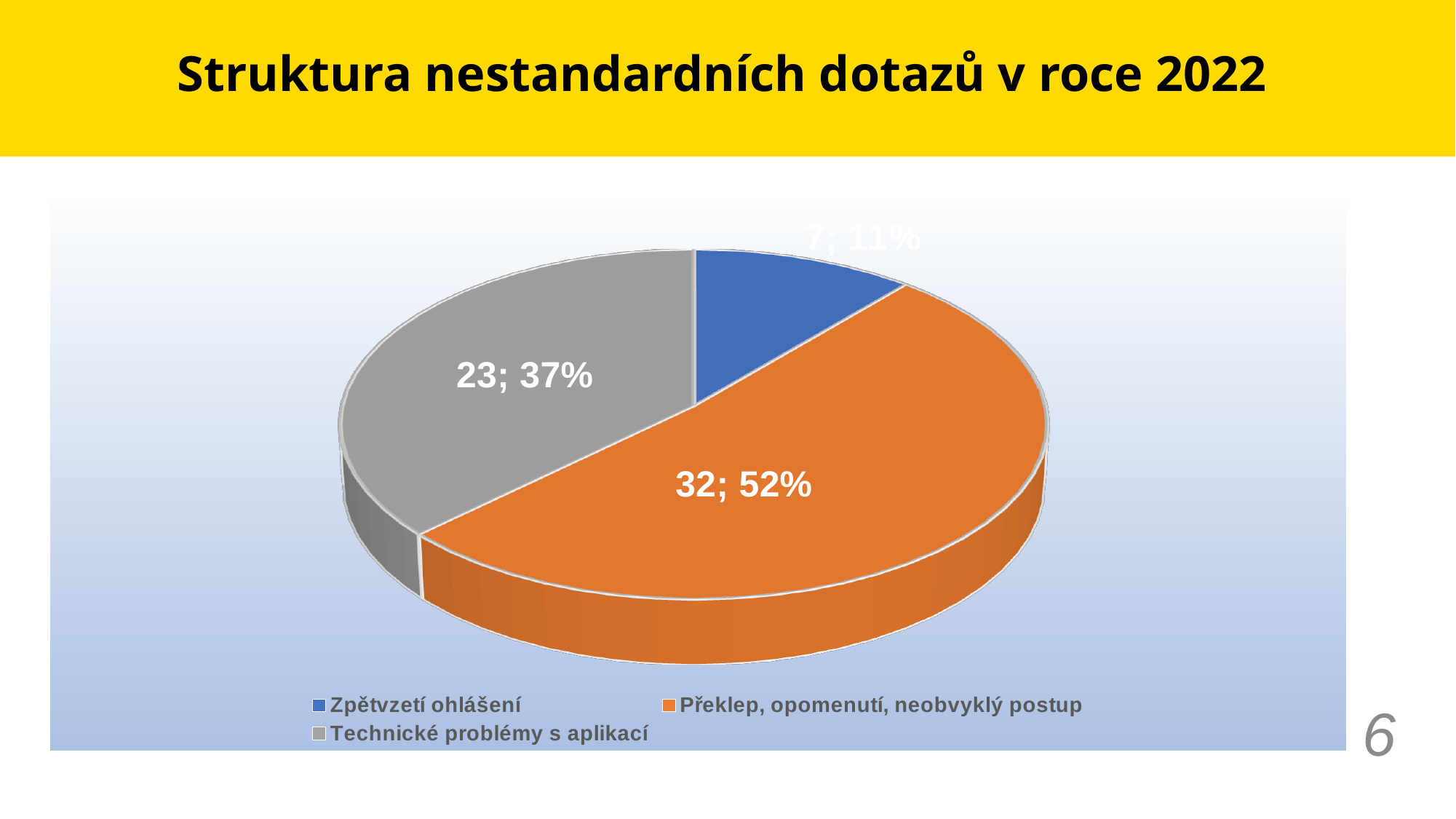
What is the title of the chart on the slide? Struktura nestandardních dotazů v roce 2022 Which category has the smallest slice? Zpětvzetí ohlášení How many slices does the pie chart have? 3 What kind of chart is shown on the slide? pie chart What is the difference between the values for Překlep, opomenutí, neobvyklý postup and Technické problémy s aplikací? 9 Which is larger, the value for Technické problémy s aplikací or the value for Zpětvzetí ohlášení? Technické problémy s aplikací What is the value for Zpětvzetí ohlášení? 7 What share of the pie does Překlep, opomenutí, neobvyklý postup represent? 52% What share of the pie does Technické problémy s aplikací represent? 37% What is the value for Technické problémy s aplikací? 23 Which category has the largest slice? Překlep, opomenutí, neobvyklý postup What is the value for Překlep, opomenutí, neobvyklý postup? 32